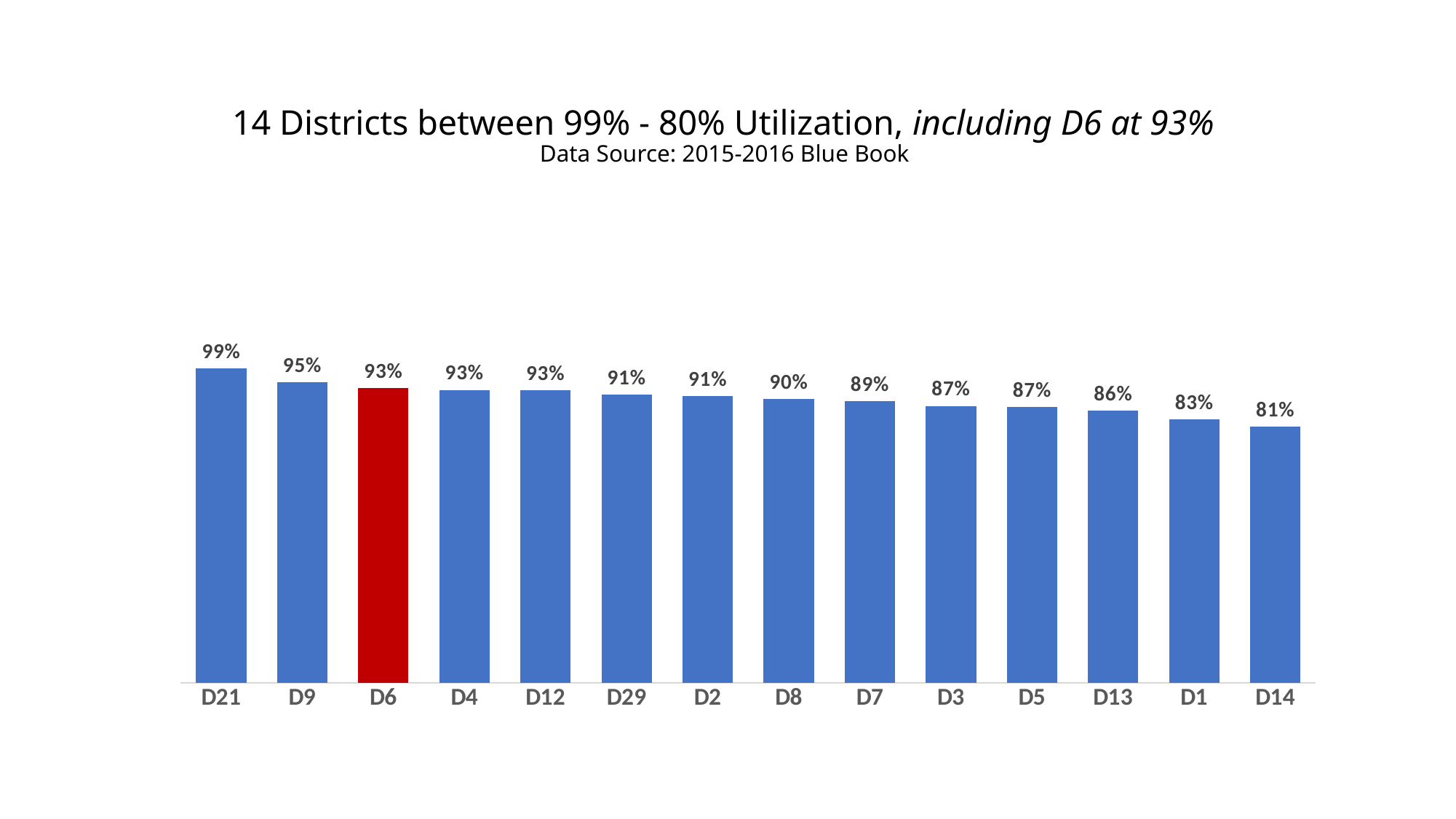
What is the difference between the utilization of D21 and D14? 18% Do the utilization values rise or fall from left to right across the chart? Fall What is the utilization value for D6? 93% What is the utilization value for D29? 91% Which district has the lowest utilization? D14 What kind of chart is shown on the slide? Bar chart Which district has the highest utilization? D21 How many districts are shown in the chart? 14 What is the difference between the utilization of D9 and D1? 12% Which district's bar is coloured red instead of blue? D6 What is the utilization value for D13? 86% Which has a higher utilization, D8 or D3? D8